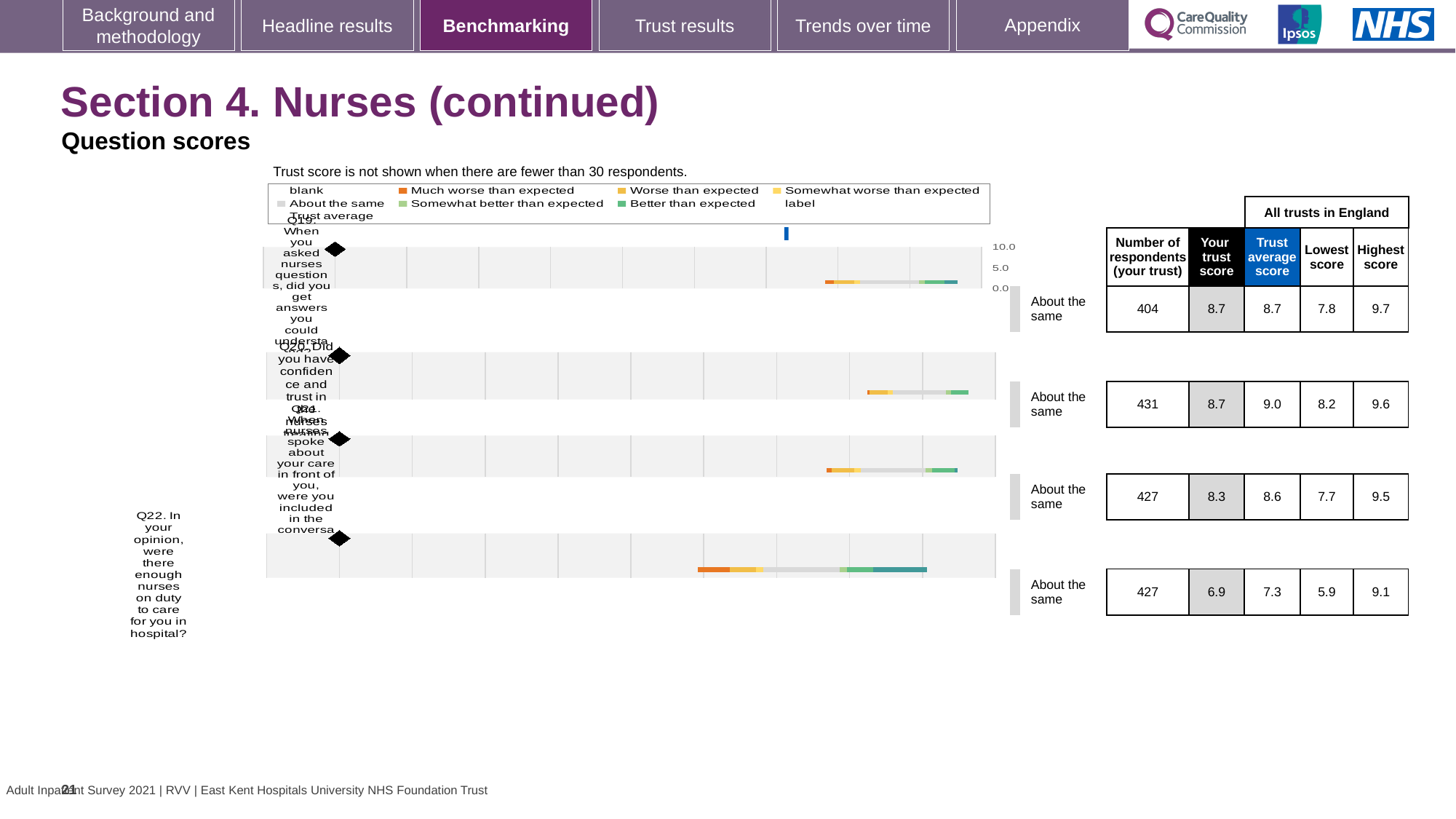
What is the highest score across all trusts in England for Q22? 9.1 In the table, how many respondents from your trust answered Q19? 404 What kind of chart is used to show the question scores on this slide? bar chart Which question has the highest number of respondents from your trust? Q20 What is the lowest score across all trusts in England for Q21? 7.7 For Q22, what is the difference between the trust average score and your trust score? 0.4 What is your trust score for Q22 (enough nurses on duty)? 6.9 What is the trust average score for Q20 (confidence and trust in nurses)? 9.0 Which question has the lowest 'Your trust score' in the table? Q22 What is the highest value shown on the chart's score axis? 10.0 How many questions (Q19 to Q22) are plotted in the chart? 4 Which is larger: your trust score for Q19 or your trust score for Q21? Q19